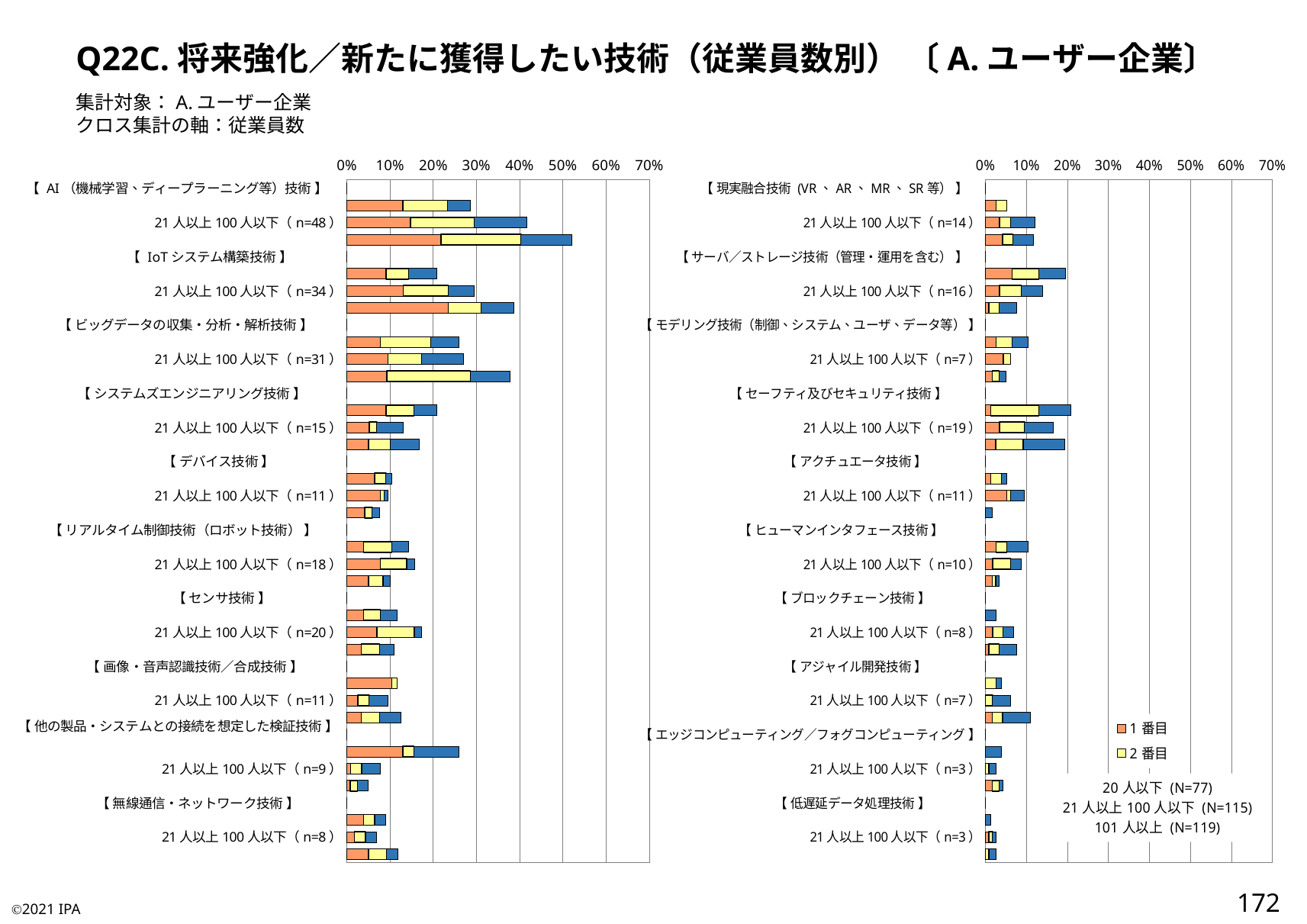
On the left chart, is the longest bar in the AI (機械学習、ディープラーニング等) 技術 group greater or less than 50%? greater What kind of chart is shown on the left side of the slide? bar chart How many series entries are shown in the legend on the right chart? 2 What is the highest value shown on the horizontal axis of the left chart? 70% On the left chart, is the bar for 21人以上100人以下 (n=48) in the AI 技術 group greater or less than 40%? greater On the left chart, which technology group contains the longest bar overall? AI（機械学習、ディープラーニング等）技術 What is the sample size (N) for the 21人以上100人以下 group according to the note on the right chart? 115 Which is longer on the left chart: the bottom bar of the AI 技術 group or the bottom bar of the IoT システム構築技術 group? AI 技術 group On the left chart, is the first (top) bar in the AI (機械学習、ディープラーニング等) 技術 group greater or less than 30%? less